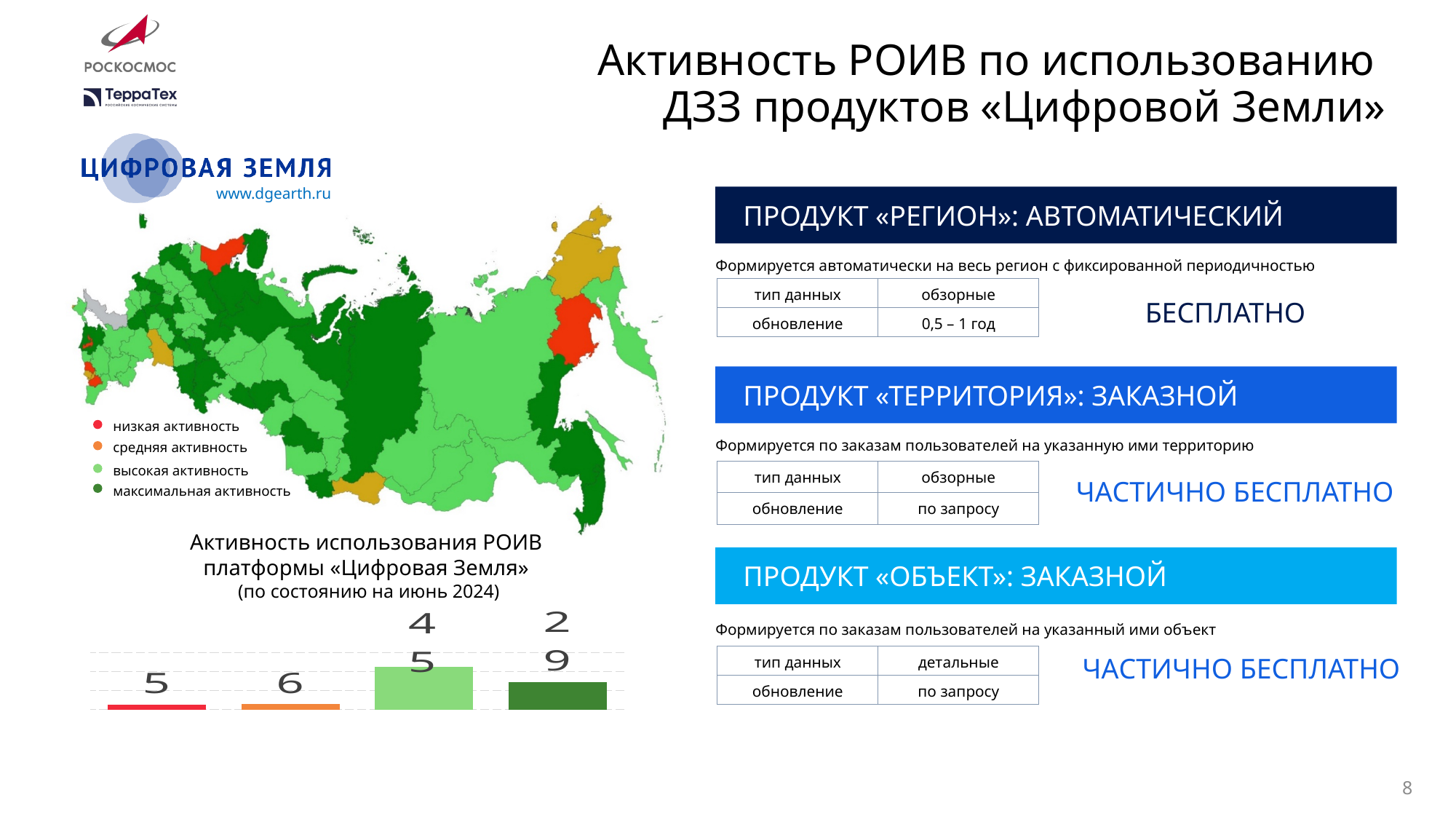
How many bars does the bar chart at the bottom left of the slide contain? 4 What type of chart is shown at the bottom left of the slide under the map? bar chart In the bar chart at the bottom left, which activity level has the lowest bar? низкая активность In the bar chart at the bottom left, what is the total of all four bars? 85 In the bar chart at the bottom left, what is the difference between the light green bar (45) and the dark green bar (29)? 16 In the bar chart at the bottom left, what value is shown for the light green bar (высокая активность)? 45 In the bar chart at the bottom left, what value is shown for the red bar (низкая активность)? 5 In the bar chart at the bottom left, which is larger: the value for the orange bar or the value for the red bar? orange bar (6) In the bar chart at the bottom left, which activity level has the highest bar? высокая активность In the bar chart at the bottom left, what value is shown for the dark green bar (максимальная активность)? 29 In the bar chart at the bottom left, what value is shown for the orange bar (средняя активность)? 6 What date does the bar chart title say the data is current as of? июнь 2024